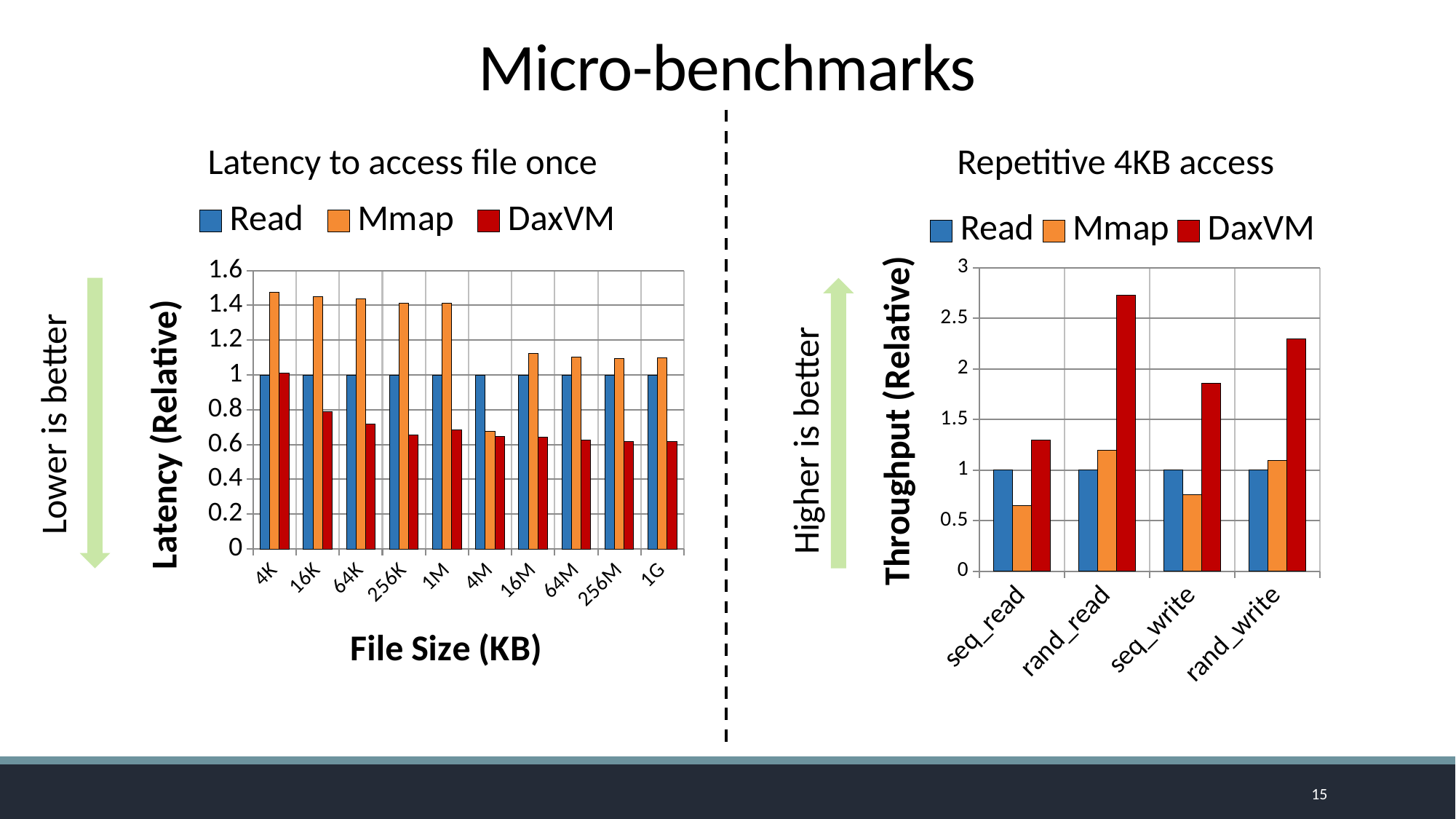
In the 'Latency to access file once' chart, what is the Read latency value for 4K? 1 In the 'Repetitive 4KB access' chart, which category has the highest DaxVM throughput? rand_read In the 'Latency to access file once' chart, is the DaxVM value for 1G greater or less than 0.8? less In the 'Repetitive 4KB access' chart, is the DaxVM value for rand_read greater or less than 2.5? greater In the 'Latency to access file once' chart, which series has the lowest bar at 256K? DaxVM In the 'Latency to access file once' chart, how many file size categories are shown on the x axis? 10 In the 'Latency to access file once' chart, how many series does the legend list? 3 In the 'Latency to access file once' chart, is the Mmap value for 4K greater or less than 1.4? greater In the 'Repetitive 4KB access' chart, how many categories are shown on the x axis? 4 In the 'Latency to access file once' chart, which series has the highest bar at 16K? Mmap In the 'Repetitive 4KB access' chart, which is larger for seq_read, the Mmap value or the DaxVM value? DaxVM In the 'Latency to access file once' chart, what kind of chart is it? bar chart